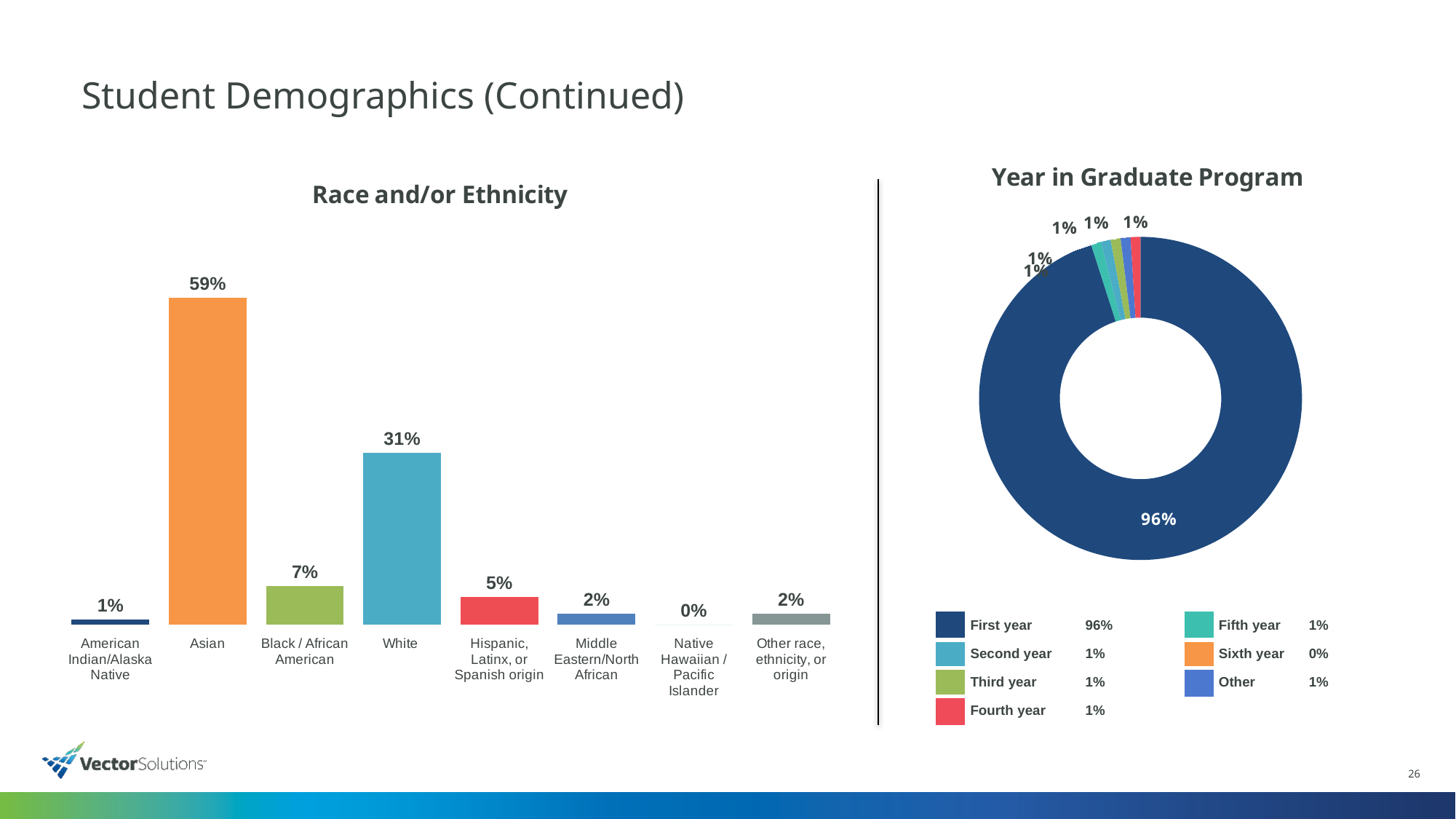
In the 'Race and/or Ethnicity' chart, which category has the lowest value? Native Hawaiian / Pacific Islander In the 'Race and/or Ethnicity' chart, what is the value for Black / African American? 7% How many categories are shown in the 'Race and/or Ethnicity' chart? 8 How many entries does the legend of the 'Year in Graduate Program' chart list? 7 In the 'Year in Graduate Program' chart, what share does First year have? 96% In the 'Race and/or Ethnicity' chart, what is the value for White? 31% In the 'Race and/or Ethnicity' chart, which category has the highest value? Asian In the 'Race and/or Ethnicity' chart, what is the value for Asian? 59% What kind of chart is the 'Race and/or Ethnicity' chart? Bar chart In the 'Year in Graduate Program' chart, what is the value for Sixth year? 0% In the 'Race and/or Ethnicity' chart, which is larger: Black / African American or Hispanic, Latinx, or Spanish origin? Black / African American In the 'Race and/or Ethnicity' chart, what is the difference between the values for Asian and White? 28%